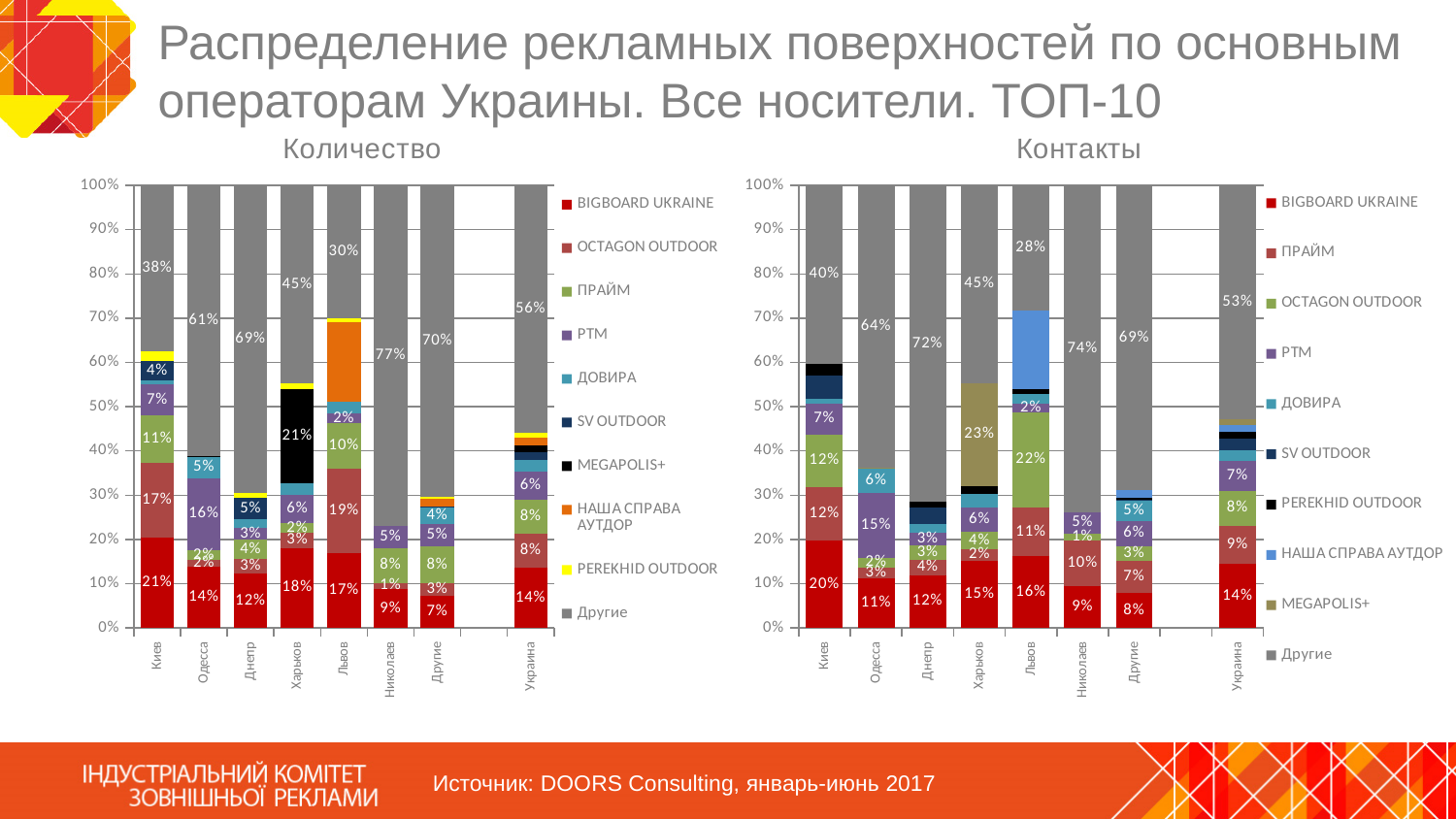
On the 'Контакты' chart, what is the 'Другие' share for Украина? 53% On the 'Контакты' chart, which city has the lowest 'Другие' share? Львов On the 'Контакты' chart, what share is labelled for 'Другие' in the Львов bar? 28% On the 'Количество' chart, what is the BIGBOARD UKRAINE share for Киев? 21% How many series does the legend of the 'Контакты' chart list? 10 On the 'Количество' chart, what is the MEGAPOLIS+ share for Харьков? 21% How many categories (cities/regions) are shown on the x axis of the 'Количество' chart? 8 On the 'Количество' chart, what share is labelled for 'Другие' in the Киев bar? 38% On the 'Количество' chart, which city has the highest 'Другие' share? Николаев On the 'Количество' chart, what is the difference between the 'Другие' share for Николаев (77%) and for Киев (38%)? 39 percentage points On the 'Контакты' chart, which has the larger BIGBOARD UKRAINE share: Киев or Украина? Киев What kind of chart is the 'Количество' chart? Stacked bar chart